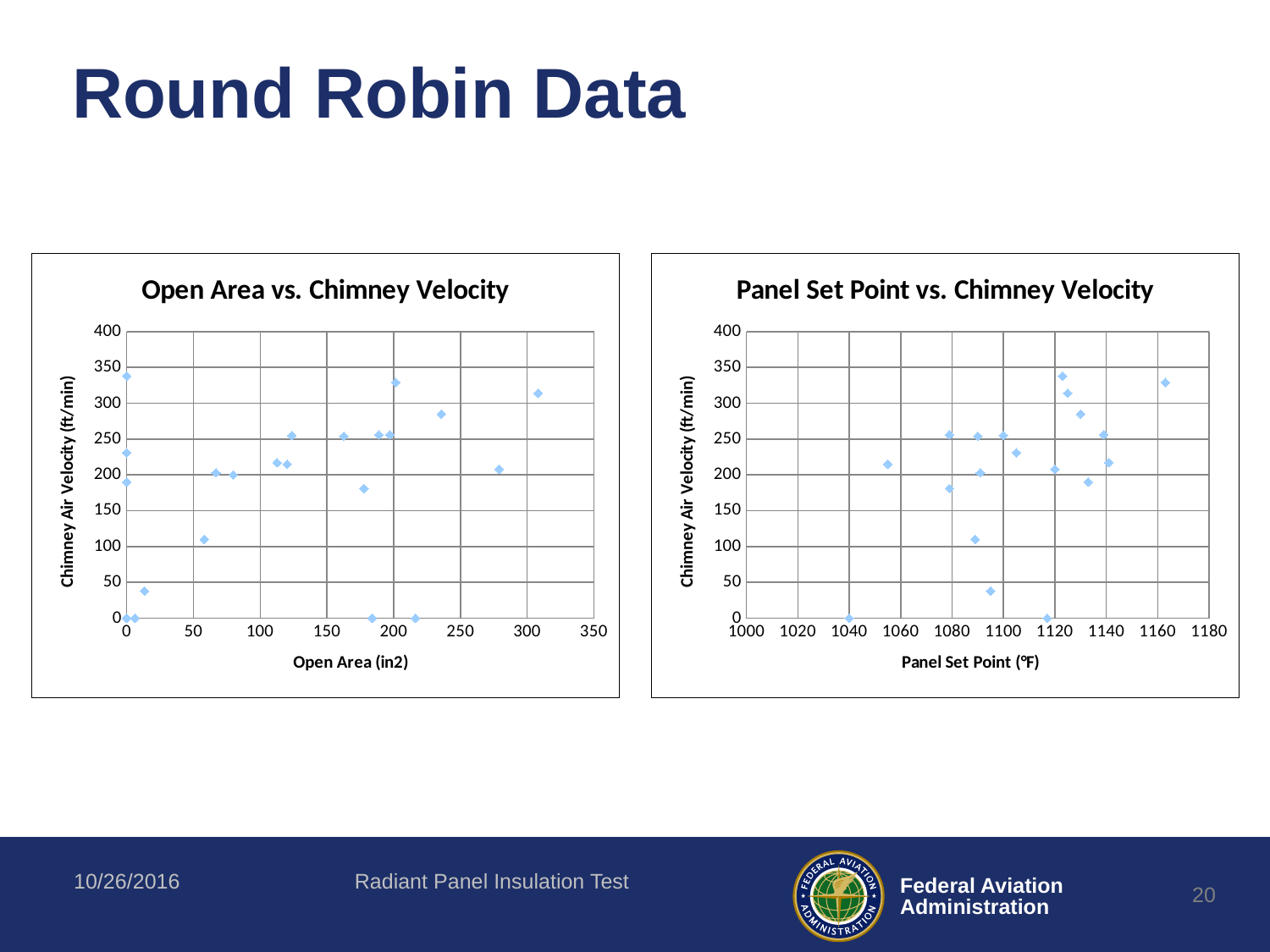
In the "Panel Set Point vs. Chimney Velocity" chart, is the chimney air velocity for the point at a panel set point of about 1055 °F greater or less than 200? greater In the "Open Area vs. Chimney Velocity" chart, is the chimney air velocity for the point at an open area of about 215 in2 greater or less than 50? less In the "Open Area vs. Chimney Velocity" chart, what is the label of the x axis? Open Area (in2) In the "Panel Set Point vs. Chimney Velocity" chart, is the chimney air velocity for the point at a panel set point of about 1095 °F greater or less than 100? less What kind of chart is the "Open Area vs. Chimney Velocity" chart on the left? Scatter chart What kind of chart is the "Panel Set Point vs. Chimney Velocity" chart on the right? Scatter chart In the "Panel Set Point vs. Chimney Velocity" chart, what is the label of the y axis? Chimney Air Velocity (ft/min)